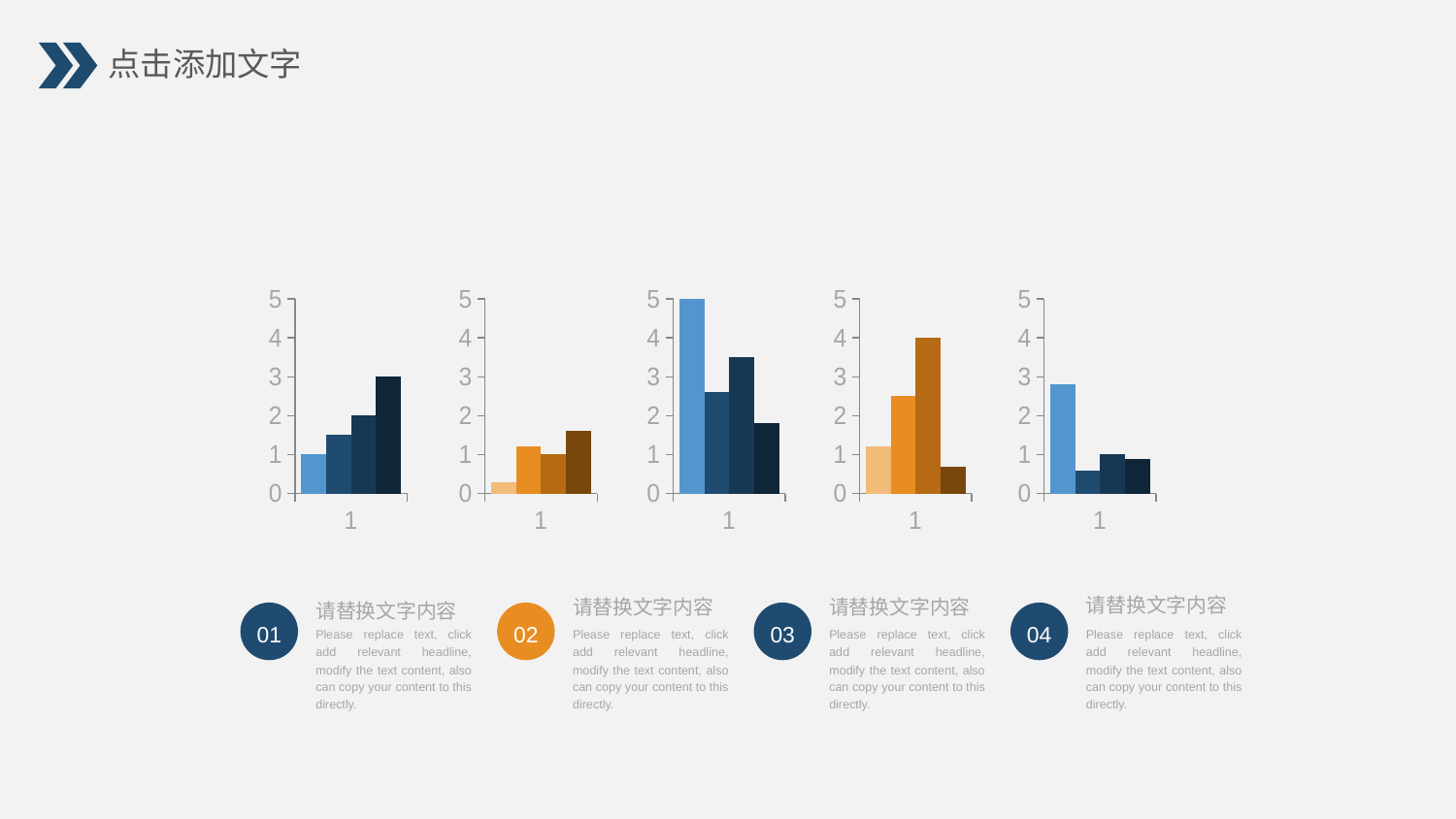
What kind of chart is the leftmost chart on the slide? bar chart In the leftmost chart, what value does the tallest bar reach? 3 In the leftmost chart, do the bars rise or fall from left to right? rise In the second chart from the left, is the tallest bar greater or less than 2? less What is the maximum value shown on the vertical axis of each chart? 5 How many charts are shown on the slide? 5 In the fourth chart from the left, what value does the tallest bar reach? 4 In the rightmost chart, is the second bar greater or less than 1? less In the middle (third) chart, what value does the tallest bar reach? 5 In the leftmost chart, how many bars are plotted? 4 In the middle (third) chart, which bar is the tallest? the first (leftmost) bar In the rightmost chart, is the first (leftmost) bar greater or less than 2? greater